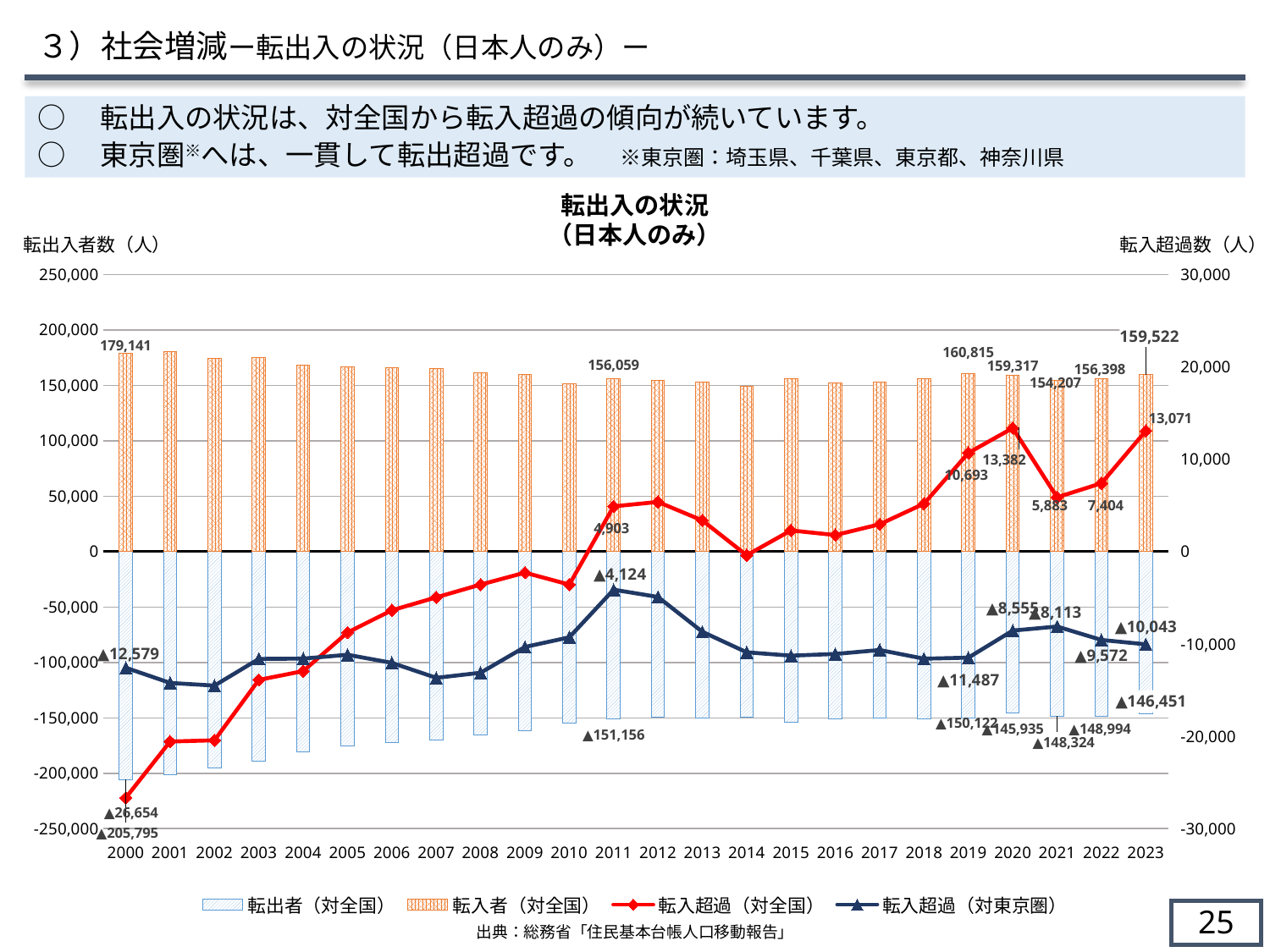
How many years are shown on the x axis of the chart 転出入の状況（日本人のみ）? 24 In the chart 転出入の状況（日本人のみ）, is the value of 転入者（対全国） for 2005 greater or less than 150,000? greater In the chart 転出入の状況（日本人のみ）, does the 転入超過（対全国） line rise or fall from 2000 to 2011? rise In the chart 転出入の状況（日本人のみ）, in which year is 転入超過（対全国） at its lowest? 2000 In the chart 転出入の状況（日本人のみ）, what is the value of 転入超過（対全国） for 2020? 13,382 In the chart 転出入の状況（日本人のみ）, what is the value of 転入者（対全国） for 2023? 159,522 In the chart 転出入の状況（日本人のみ）, which year has the larger 転入超過（対全国） value, 2020 or 2023? 2020 How many series does the legend of the chart 転出入の状況（日本人のみ） list? 4 In the chart 転出入の状況（日本人のみ）, what is the value of 転入超過（対東京圏） for 2011? ▲4,124 In the chart 転出入の状況（日本人のみ）, what is the value of 転出者（対全国） for 2000? ▲205,795 In the chart 転出入の状況（日本人のみ）, how much higher is 転入者（対全国） in 2023 than in 2022? 3,124 What kind of chart is 転出入の状況（日本人のみ）? Combined bar and line chart